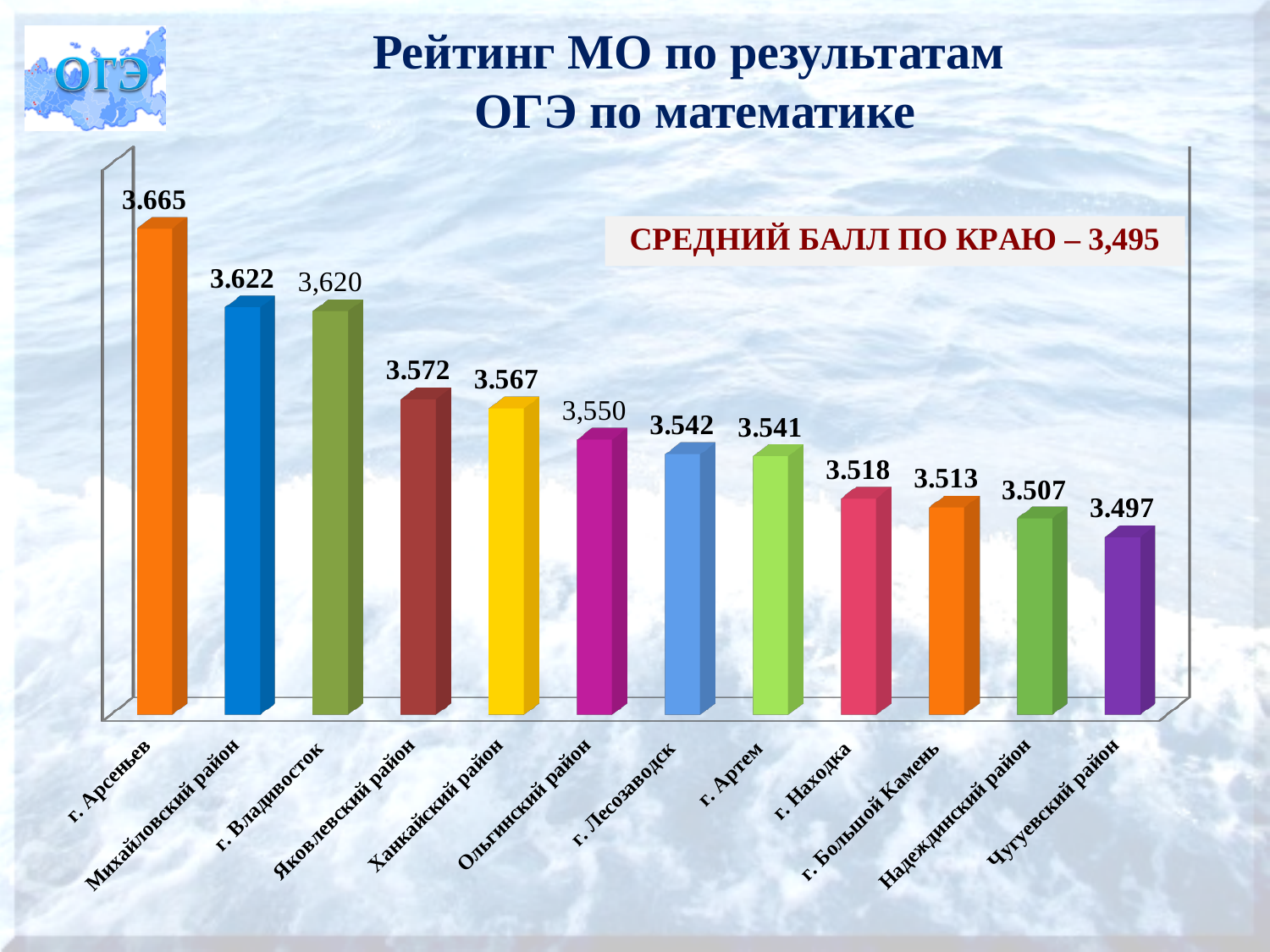
What is the difference between the values for г. Арсеньев and Чугуевский район? 0.168 What is the value for г. Арсеньев? 3.665 Do the values rise or fall from left to right along the x axis? fall What is the value for г. Владивосток? 3,620 Which category has the lowest value? Чугуевский район Which category has the highest value? г. Арсеньев How many categories are shown in the chart? 12 What kind of chart is shown on the slide? bar chart What is the value for Ольгинский район? 3,550 What is the value for Чугуевский район? 3.497 Which is larger, the value for Ханкайский район or the value for г. Находка? Ханкайский район What is the difference between the values for Михайловский район and Яковлевский район? 0.050